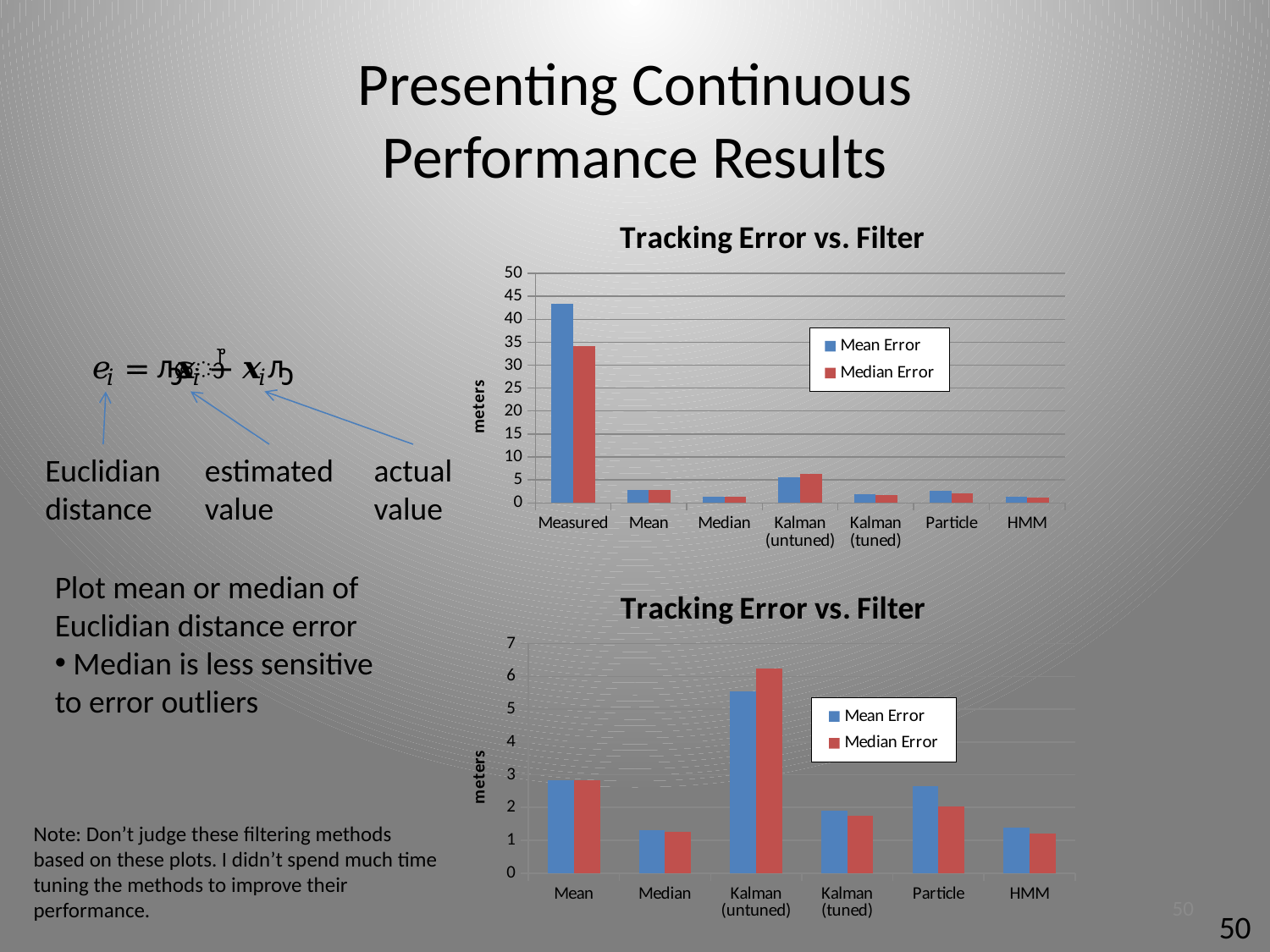
How many series does the legend of the bottom chart list? 2 In the bottom chart, for Kalman (untuned), which is larger: Mean Error or Median Error? Median Error In the bottom chart, for Particle, which is larger: Mean Error or Median Error? Mean Error In the top chart, which category has the highest Mean Error? Measured What is the y-axis label of the bottom chart? meters In the top chart, is the Mean Error value for Measured greater or less than 40? greater How many categories are shown on the x axis of the bottom chart? 6 What type of chart is the top chart on the slide? bar chart How many categories are shown on the x axis of the top chart? 7 In the bottom chart, which category has the highest Median Error? Kalman (untuned) In the bottom chart, is the Mean Error value for Mean greater or less than 3? less In the bottom chart, is the Mean Error value for Kalman (untuned) greater or less than 5? greater